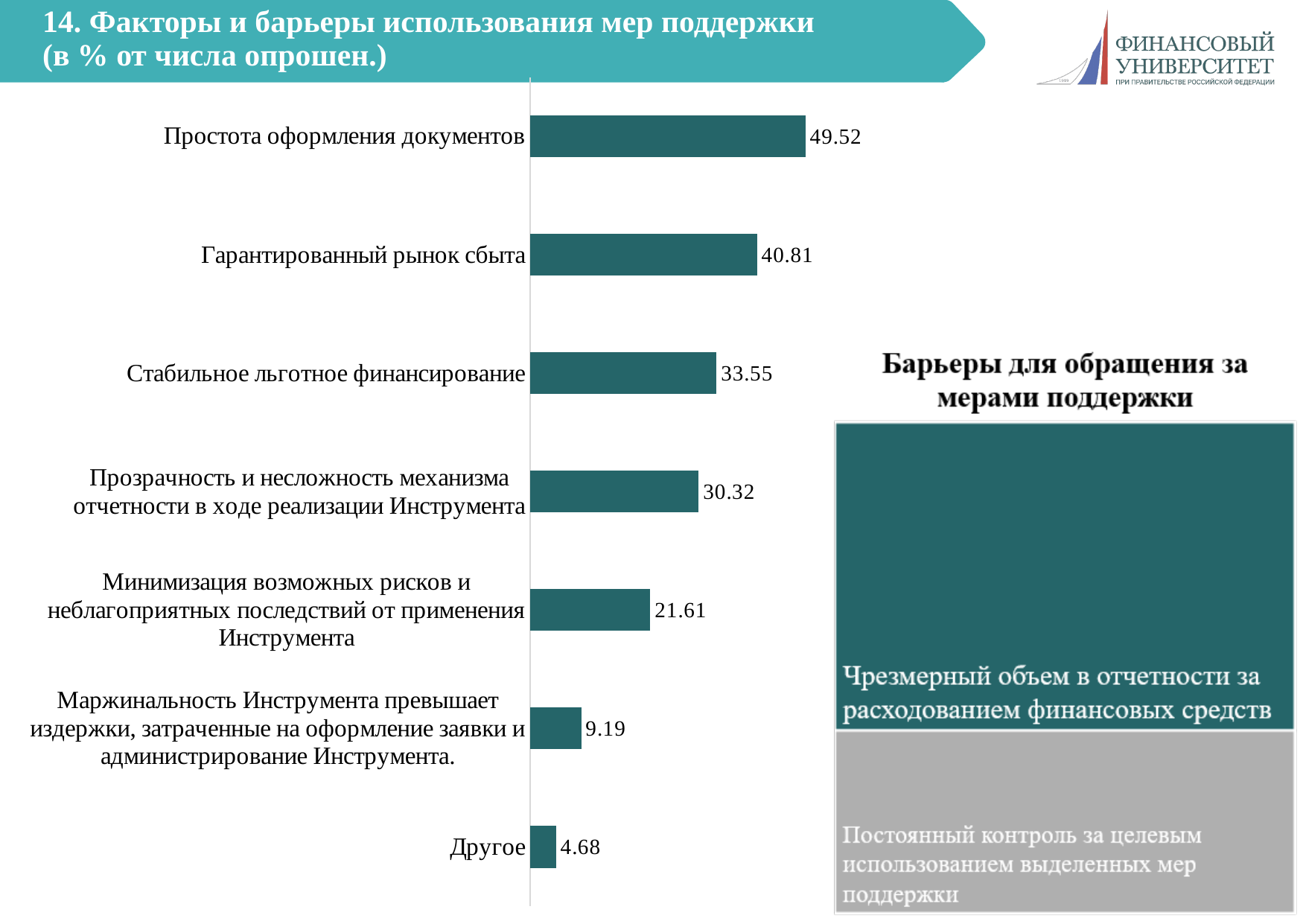
What is the title of the box to the right of the bar chart? Барьеры для обращения за мерами поддержки Which category has the lowest value in the bar chart? Другое What is the value for «Другое»? 4.68 What is the value for «Минимизация возможных рисков и неблагоприятных последствий от применения Инструмента»? 21.61 What is the value for «Стабильное льготное финансирование»? 33.55 How many categories are shown in the bar chart? 7 What is the value for «Гарантированный рынок сбыта»? 40.81 Which is larger: the value for «Стабильное льготное финансирование» or for «Прозрачность и несложность механизма отчетности в ходе реализации Инструмента»? Стабильное льготное финансирование What is the difference between the values for «Простота оформления документов» and «Гарантированный рынок сбыта»? 8.71 What kind of chart is shown on the slide? Bar chart What is the value for «Простота оформления документов» in the bar chart? 49.52 Which category has the highest value in the bar chart? Простота оформления документов